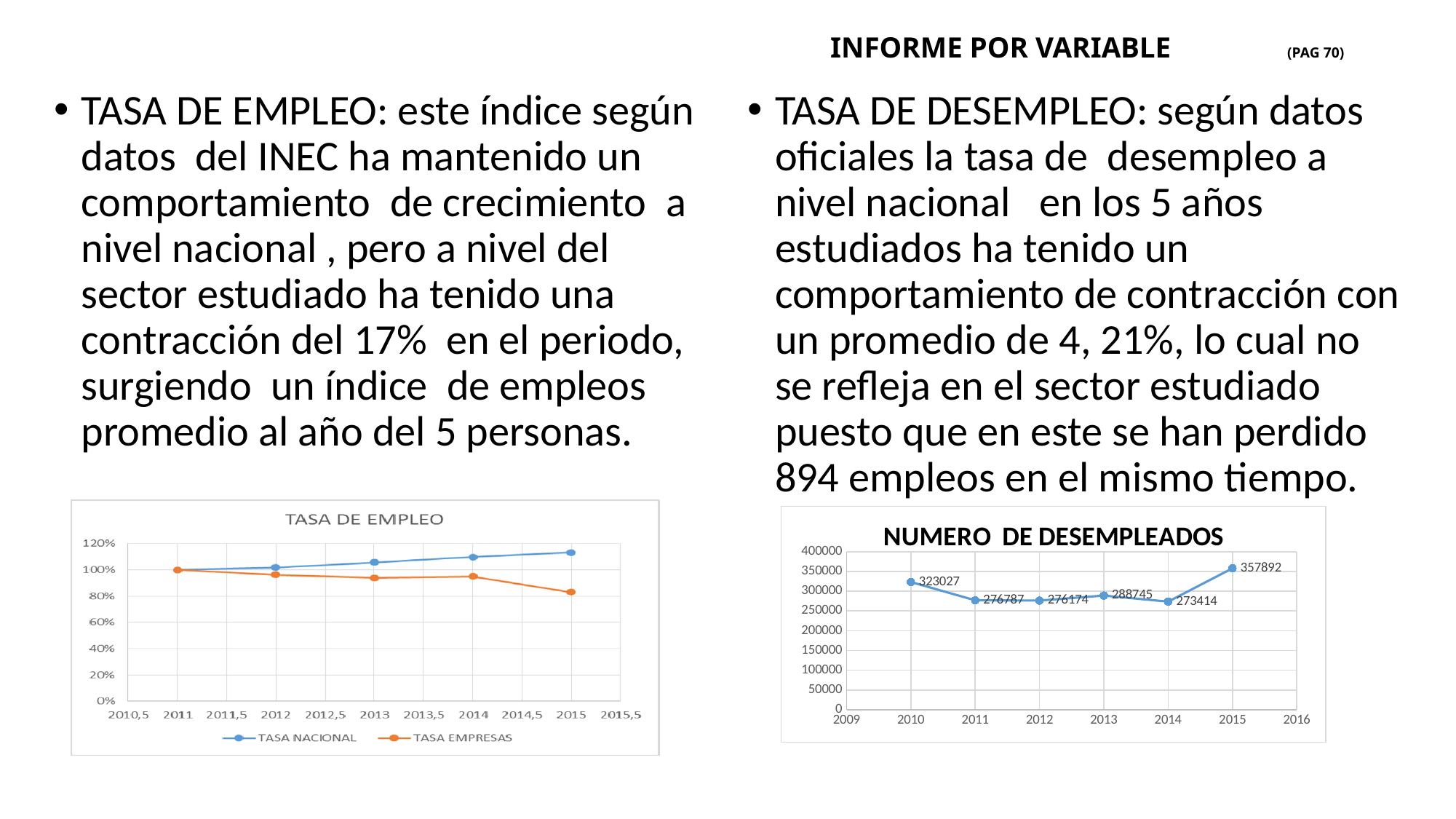
What kind of chart is the TASA DE EMPLEO chart? line chart In the TASA DE EMPLEO chart, does the TASA EMPRESAS series rise or fall from 2011 to 2015? fall In the NUMERO DE DESEMPLEADOS chart, which year has the highest value? 2015 In the NUMERO DE DESEMPLEADOS chart, how many data points are plotted? 6 In the NUMERO DE DESEMPLEADOS chart, what is the difference between the 2015 value and the 2010 value? 34865 In the NUMERO DE DESEMPLEADOS chart, what is the value for 2013? 288745 In the NUMERO DE DESEMPLEADOS chart, which year has the lowest value? 2014 In the NUMERO DE DESEMPLEADOS chart, what is the value for 2010? 323027 In the TASA DE EMPLEO chart, how many series does the legend list? 2 In the TASA DE EMPLEO chart, is the value for TASA EMPRESAS in 2015 greater or less than 100%? less In the NUMERO DE DESEMPLEADOS chart, which is larger, the value for 2011 or the value for 2012? 2011 In the NUMERO DE DESEMPLEADOS chart, does the value rise or fall from 2014 to 2015? rise